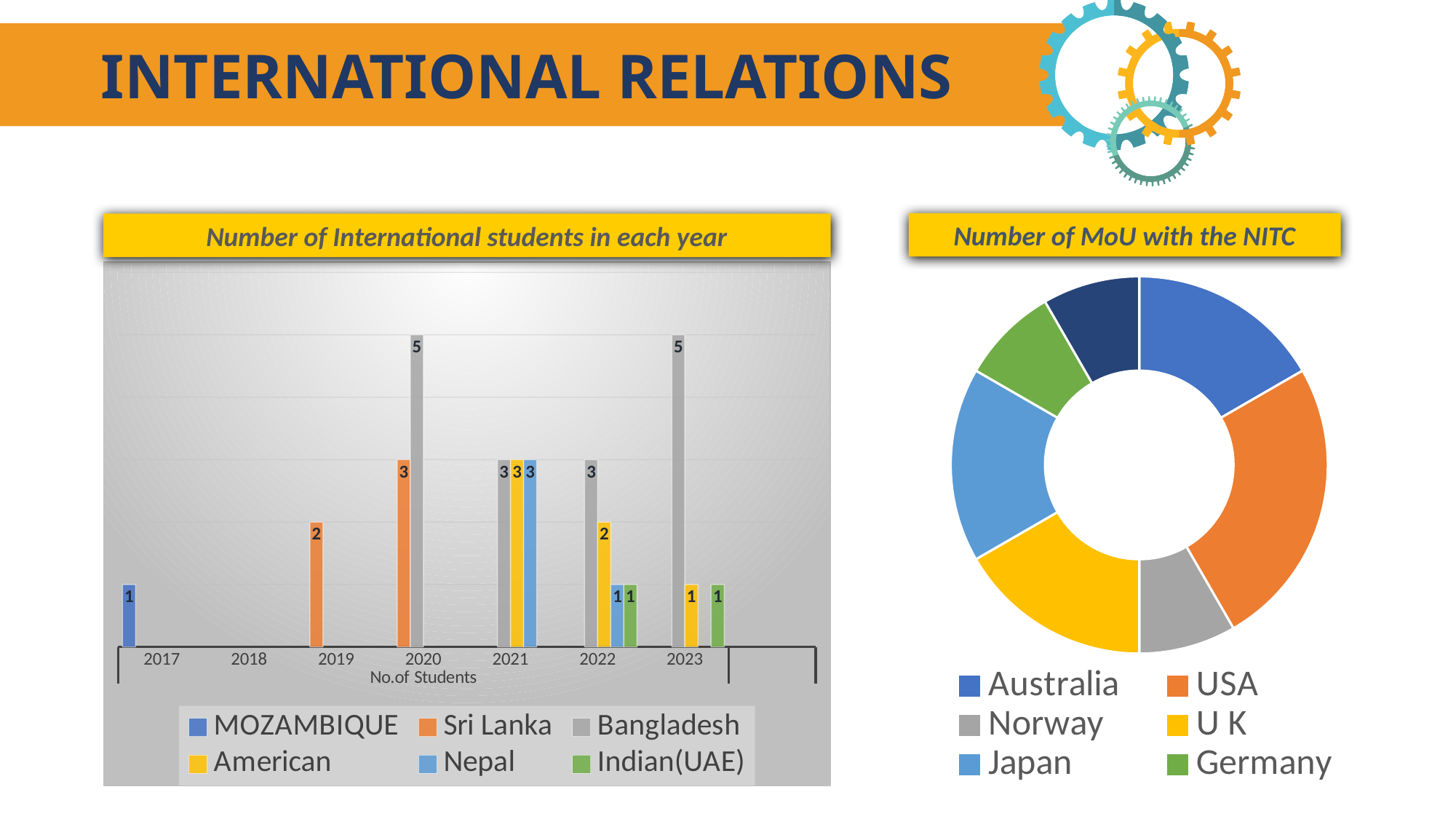
In the 'Number of International students in each year' chart, which series has the highest value in 2022? Bangladesh In the 'Number of International students in each year' chart, what is the value for American in 2022? 2 In the 'Number of International students in each year' chart, what is the value for Sri Lanka in 2019? 2 In the 'Number of International students in each year' chart, what is the difference between Bangladesh and Sri Lanka in 2020? 2 What kind of chart is the 'Number of MoU with the NITC' chart? Doughnut (pie) chart In the 'Number of International students in each year' chart, what is the value for MOZAMBIQUE in 2017? 1 In the 'Number of International students in each year' chart, what is the value for Bangladesh in 2020? 5 In the 'Number of International students in each year' chart, which is larger in 2023: Bangladesh or American? Bangladesh In the 'Number of International students in each year' chart, how many years are shown on the x axis? 7 In the 'Number of MoU with the NITC' chart, which country has the largest slice? USA In the 'Number of International students in each year' chart, how many series does the legend list? 6 What kind of chart is the 'Number of International students in each year' chart? Bar chart